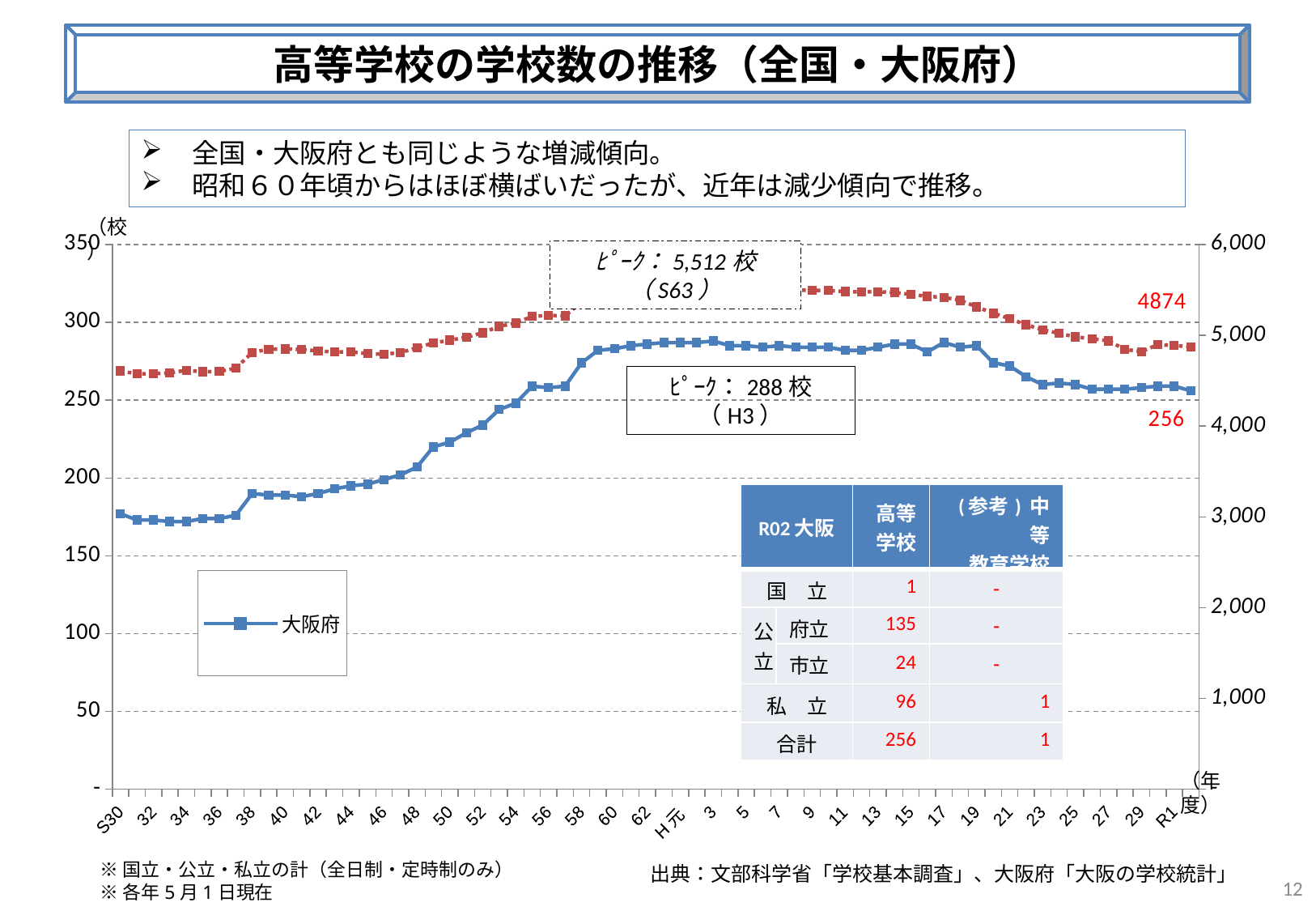
Does the 大阪府 series rise or fall between H19 and R1? fall According to the annotation, what was the peak number of schools for the national (全国) series and in which year? 5,512 校 (S63) What is the latest value labelled for the 大阪府 series at the right end of the chart? 256 By how much is the latest 大阪府 value (256) below its peak of 288? 32 According to the annotation, what was the peak number of schools for 大阪府 and in which year? 288 校 (H3) What is the title of the chart on the slide? 高等学校の学校数の推移（全国・大阪府） How many series does the chart's legend list? 1 Which series is named in the chart's legend? 大阪府 What kind of chart is shown on the slide? line chart Is the value for 大阪府 at S30 greater or less than 200? less What is the latest value labelled for the national (red) series at the right end of the chart? 4874 By how much is the latest national value (4874) below its peak of 5,512? 638